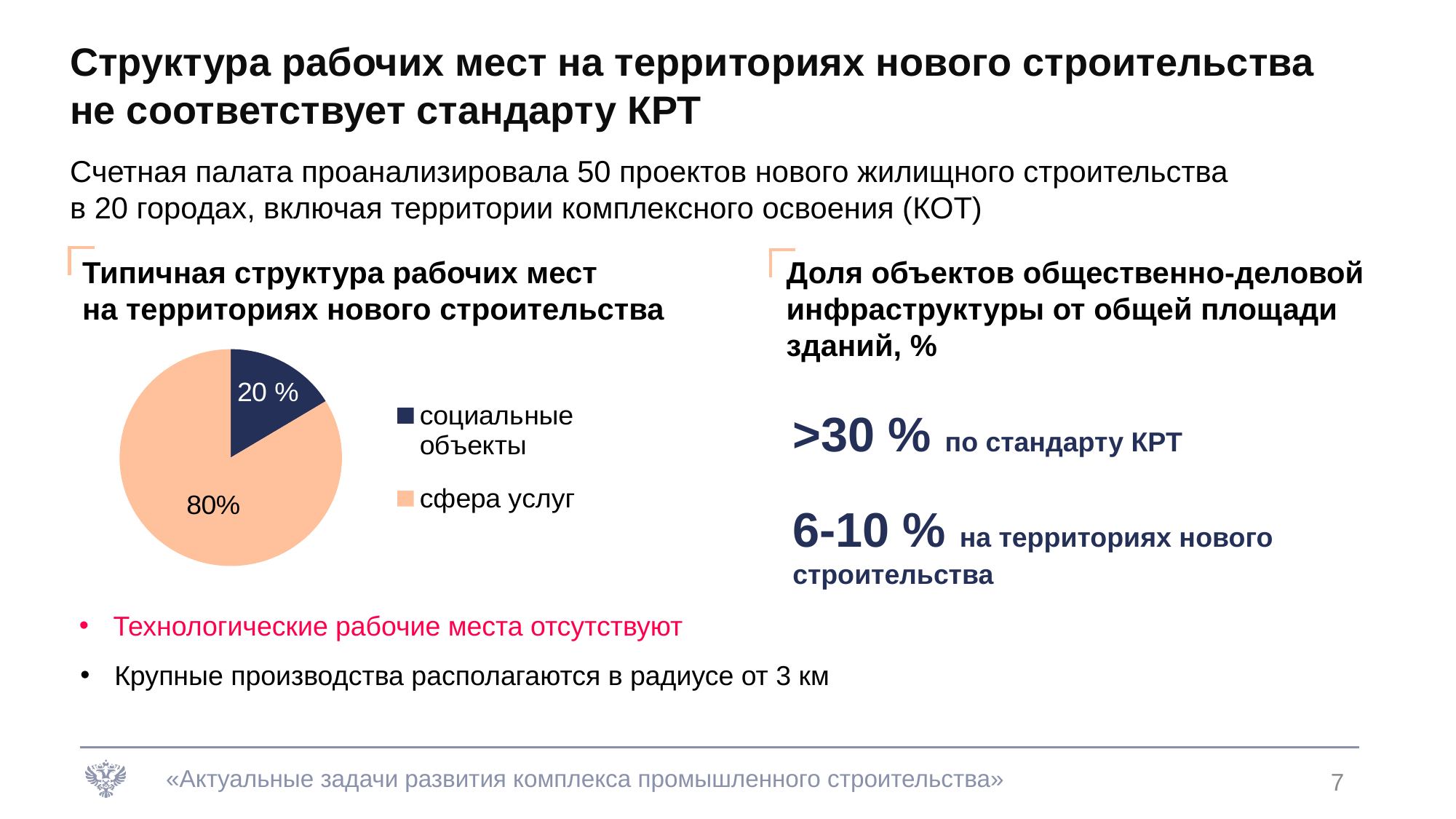
How many slices does the pie chart have? 2 What is the title of the pie chart? Типичная структура рабочих мест на территориях нового строительства Which is larger in the pie chart: "социальные объекты" or "сфера услуг"? сфера услуг What share of the pie chart does "социальные объекты" take? 20 % What is the difference in percentage points between the "сфера услуг" slice and the "социальные объекты" slice? 60 Which slice of the pie chart is the smallest? социальные объекты Which legend entry of the pie chart is shown in dark blue? социальные объекты What share of the pie chart does "сфера услуг" take? 80% How many entries does the legend of the pie chart list? 2 Which slice of the pie chart is the largest? сфера услуг What kind of chart is shown on the slide? pie chart